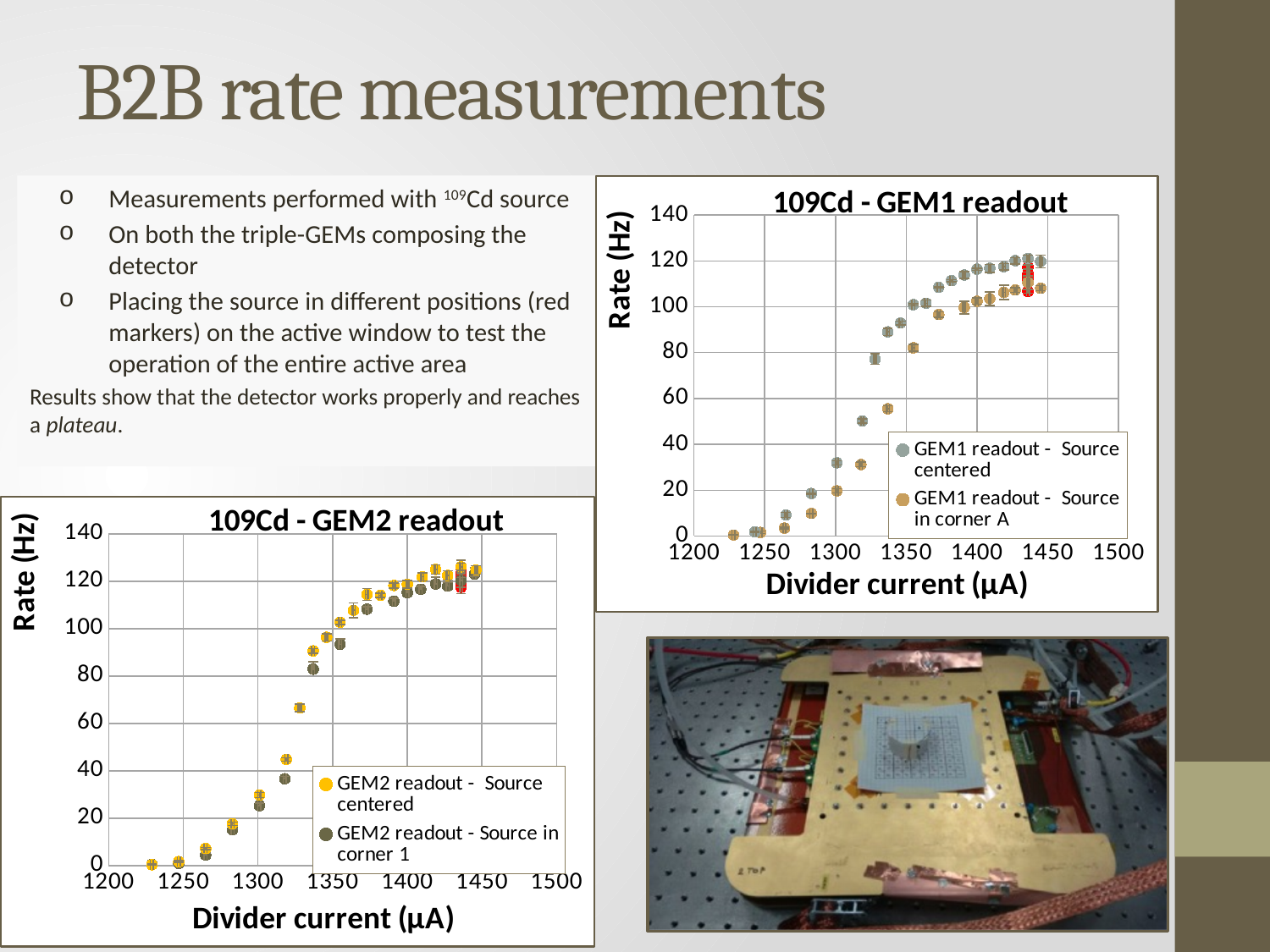
What kind of chart is the "109Cd - GEM1 readout" chart? Scatter chart In the "109Cd - GEM2 readout" chart, what are the two series named in the legend? GEM2 readout - Source centered; GEM2 readout - Source in corner 1 In the "109Cd - GEM2 readout" chart, does the rate rise or fall as the divider current increases? Rise In the "109Cd - GEM1 readout" chart, what is the title of the x axis? Divider current (µA) What kind of chart is the "109Cd - GEM2 readout" chart? Scatter chart How many series does the legend of the "109Cd - GEM1 readout" chart list? 2 In the "109Cd - GEM1 readout" chart, is the rate for the source-centered series at 1300 µA greater or less than 40 Hz? less How many series does the legend of the "109Cd - GEM2 readout" chart list? 2 In the "109Cd - GEM2 readout" chart, is the rate for the source-centered series at 1250 µA greater or less than 20 Hz? less In the "109Cd - GEM1 readout" chart, is the rate for the source-centered series at 1450 µA greater or less than 100 Hz? greater In the "109Cd - GEM1 readout" chart, does the rate rise or fall as the divider current increases? Rise